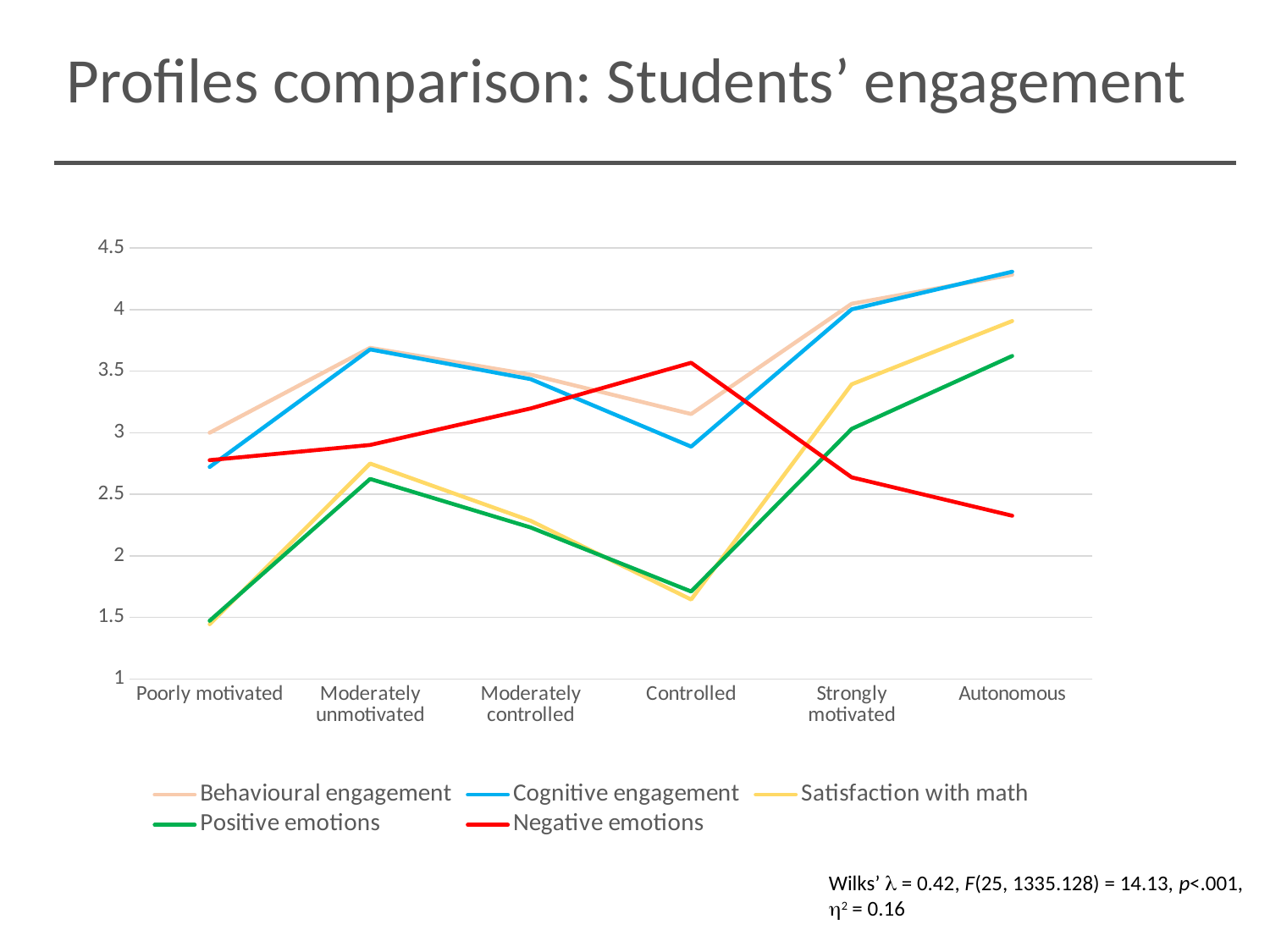
How many student profiles are shown along the x axis? 6 What kind of chart is shown on the slide? line chart Is the value for Satisfaction with math in the Poorly motivated profile greater or less than 2? less Is the value for Cognitive engagement in the Autonomous profile greater or less than 4? greater How many series does the legend list? 5 In the Controlled profile, which is larger: Negative emotions or Cognitive engagement? Negative emotions Is the value for Negative emotions in the Controlled profile greater or less than 3? greater Which profile has the highest value for Negative emotions? Controlled Does the Negative emotions line rise or fall from Controlled to Autonomous? fall Which profile has the highest value for Positive emotions? Autonomous Which profile has the lowest value for Negative emotions? Autonomous